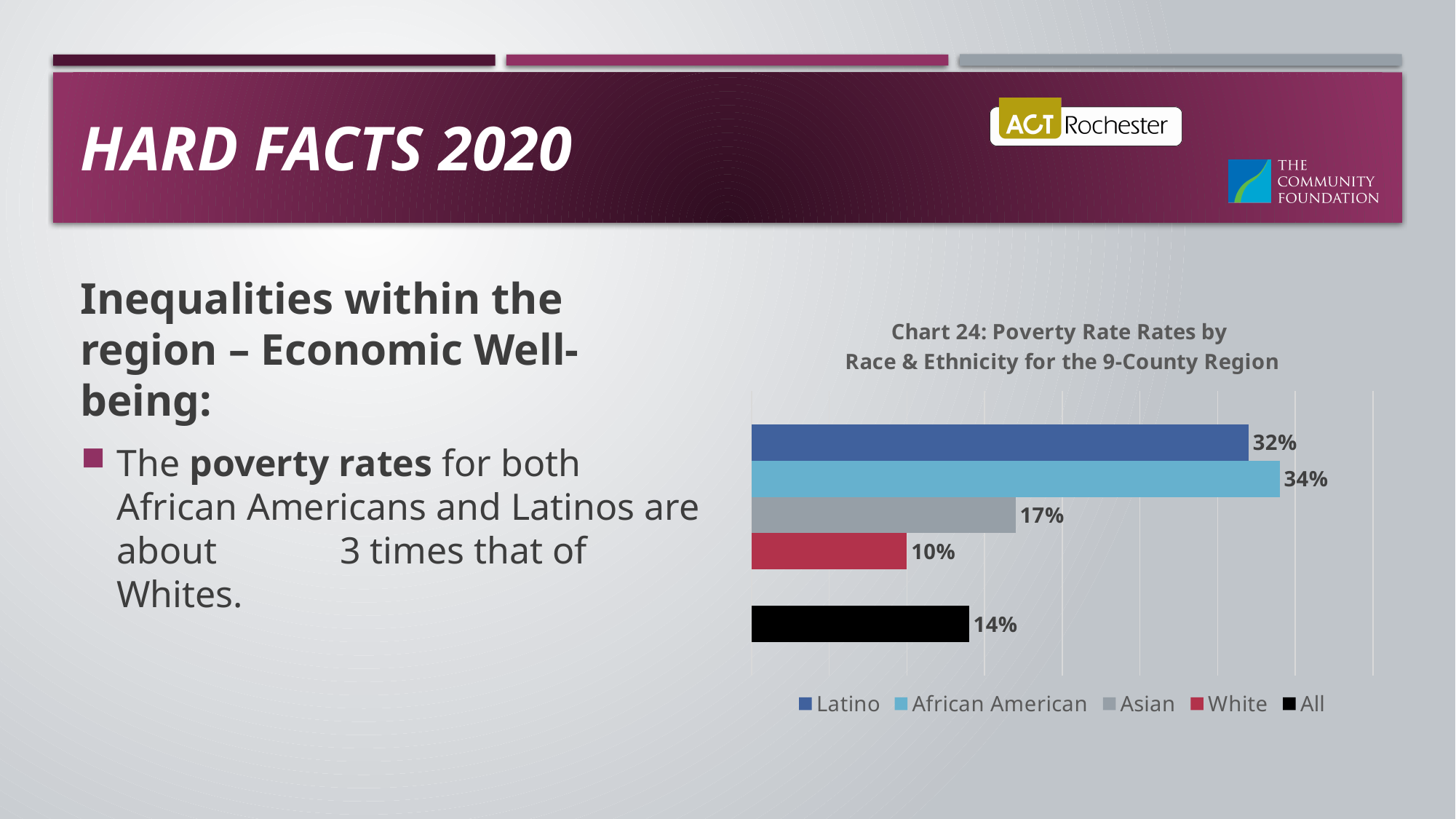
What kind of chart is Chart 24? Bar chart What is the poverty rate for African Americans in Chart 24? 34% What is the poverty rate for All in Chart 24? 14% Which group has the lowest poverty rate in Chart 24? White What is the difference between the African American and White poverty rates in Chart 24? 24% Which is larger in Chart 24, the poverty rate for Asians or for All? Asian What colour is the bar for All in Chart 24? Black Which group has the highest poverty rate in Chart 24? African American What is the poverty rate for Latinos in Chart 24? 32% What is the poverty rate for Asians in Chart 24? 17% How many series does the legend of Chart 24 list? 5 What is the poverty rate for Whites in Chart 24? 10%